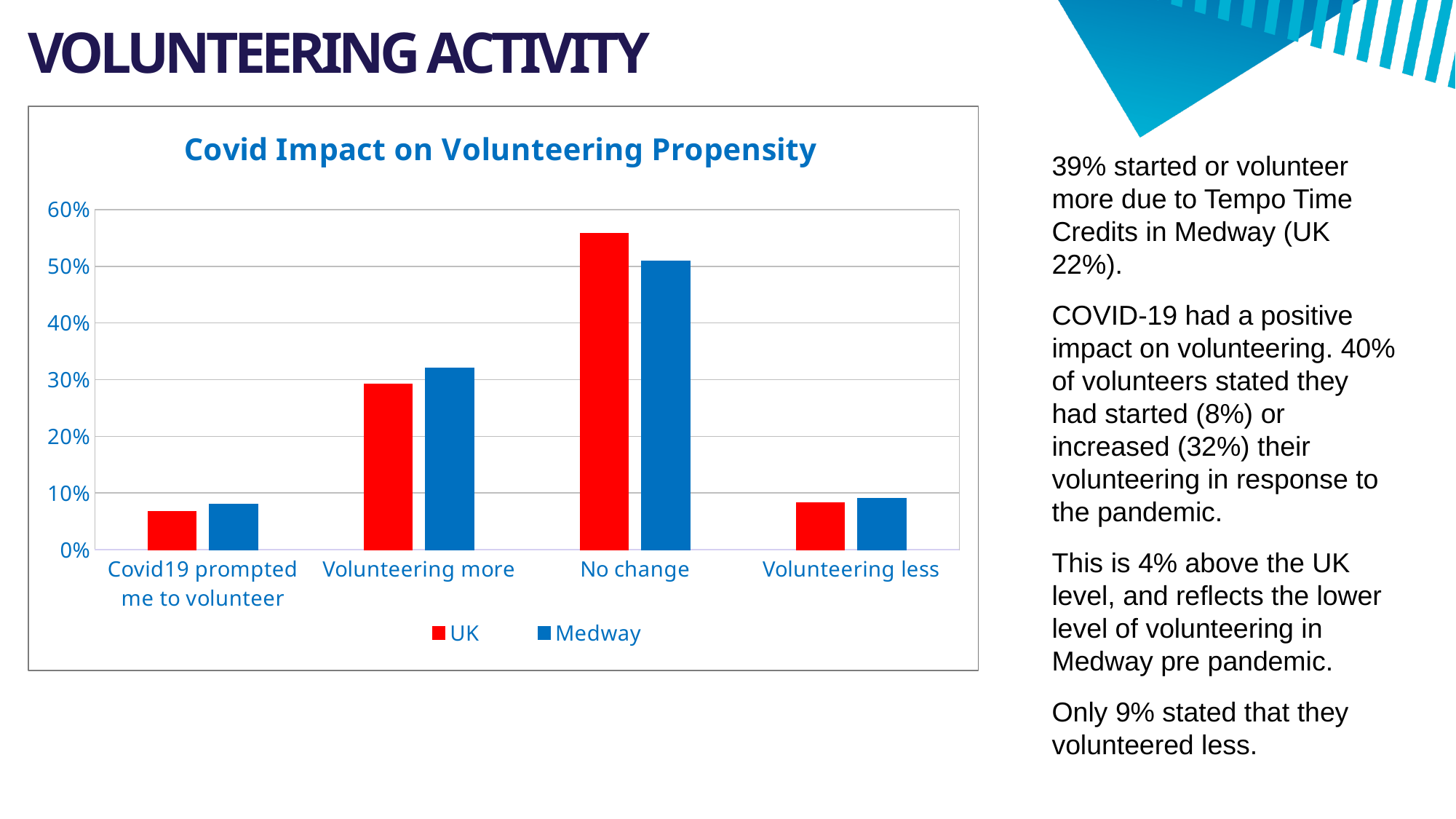
Which colour represents Medway in the chart? Blue How many series does the chart legend list? 2 For the 'Volunteering more' category, which is larger, the UK value or the Medway value? Medway Which category has the highest value for the UK series? No change Is the UK value for 'Covid19 prompted me to volunteer' greater or less than 10%? less For the 'No change' category, which is larger, the UK value or the Medway value? UK Is the Medway value for 'Volunteering more' greater or less than 20%? greater What is the title of the chart? Covid Impact on Volunteering Propensity Is the UK value for 'No change' greater or less than 50%? greater What kind of chart is shown on the slide? Bar chart Which category has the highest value for the Medway series? No change How many categories are shown on the x axis of the chart? 4